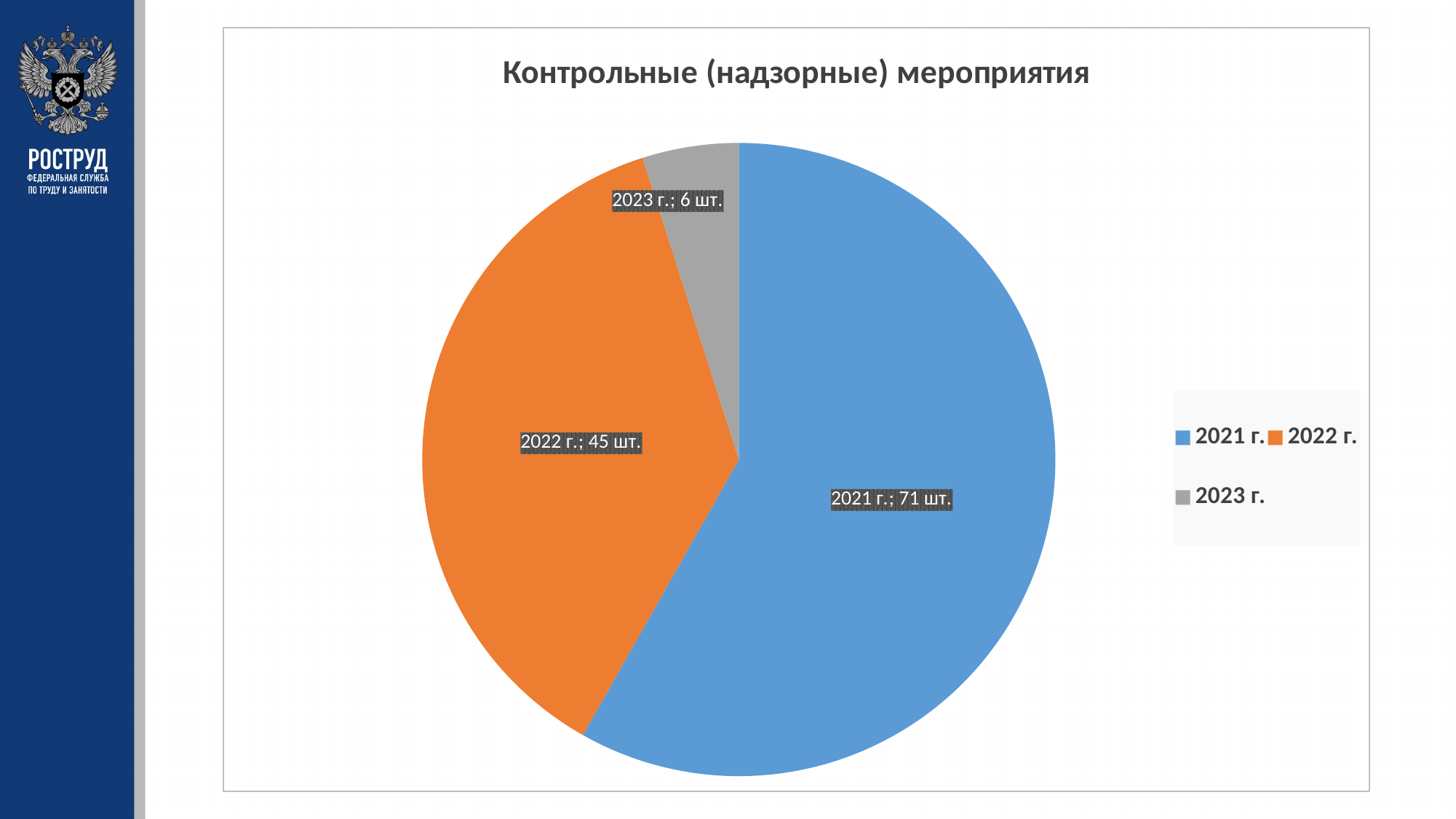
How many entries does the legend list? 3 What is the value for 2023 г.? 6 шт. What is the value for 2021 г.? 71 шт. Which is larger, the value for 2022 г. or 2023 г.? 2022 г. What is the difference between the values for 2022 г. and 2023 г.? 39 шт. What is the title of the chart? Контрольные (надзорные) мероприятия What is the difference between the values for 2021 г. and 2022 г.? 26 шт. How many slices does the pie chart have? 3 What is the value for 2022 г.? 45 шт. What kind of chart is shown on the slide? Pie chart Which year has the largest slice? 2021 г. Which year has the smallest slice? 2023 г.